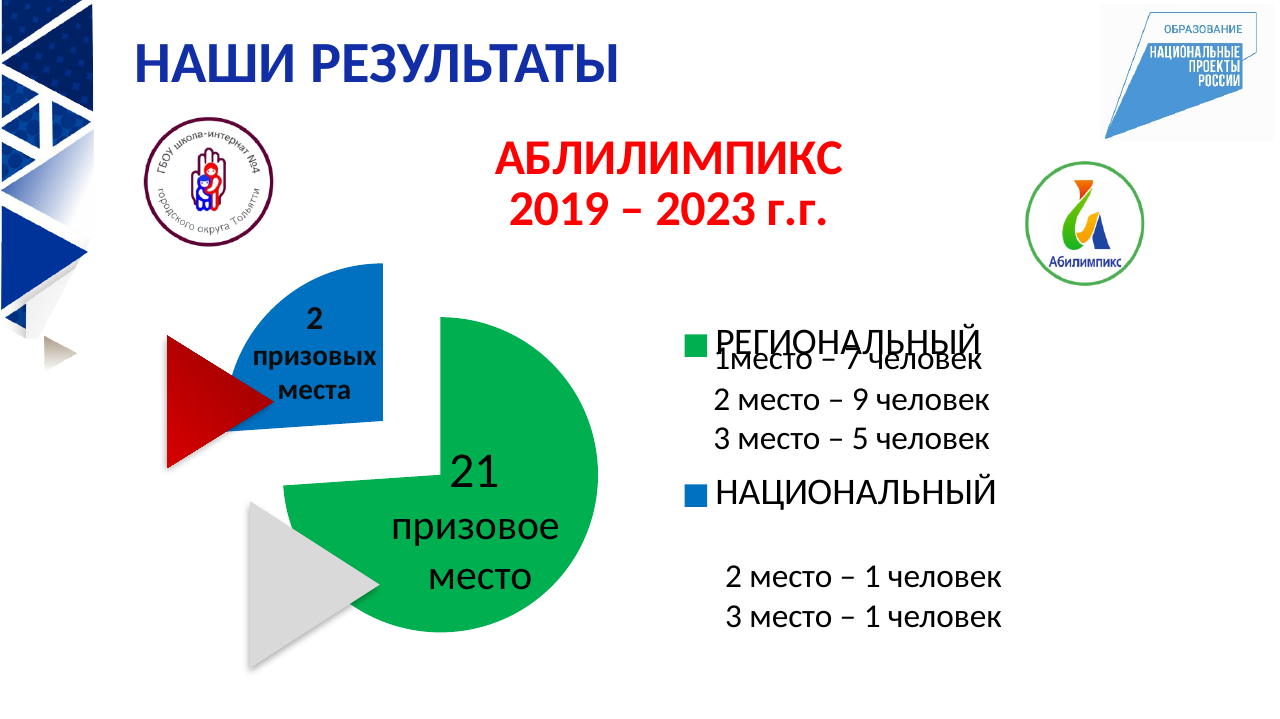
How many prize places does the green (РЕГИОНАЛЬНЫЙ) slice of the pie chart show? 21 What is the total number of prize places shown across both slices of the pie chart? 23 How many slices does the pie chart have? 2 What kind of chart is shown on the slide? pie chart What title is shown above the pie chart? АБЛИЛИМПИКС 2019 – 2023 г.г. Is the value for the НАЦИОНАЛЬНЫЙ slice larger or smaller than the value for the РЕГИОНАЛЬНЫЙ slice? smaller Which level has the larger slice in the pie chart, РЕГИОНАЛЬНЫЙ or НАЦИОНАЛЬНЫЙ? РЕГИОНАЛЬНЫЙ How many entries does the chart legend list? 2 How many prize places does the blue (НАЦИОНАЛЬНЫЙ) slice of the pie chart show? 2 What colour is the РЕГИОНАЛЬНЫЙ slice in the pie chart? green What is the difference between the number of prize places in the РЕГИОНАЛЬНЫЙ slice and the НАЦИОНАЛЬНЫЙ slice? 19 Which level has the smaller slice in the pie chart? НАЦИОНАЛЬНЫЙ